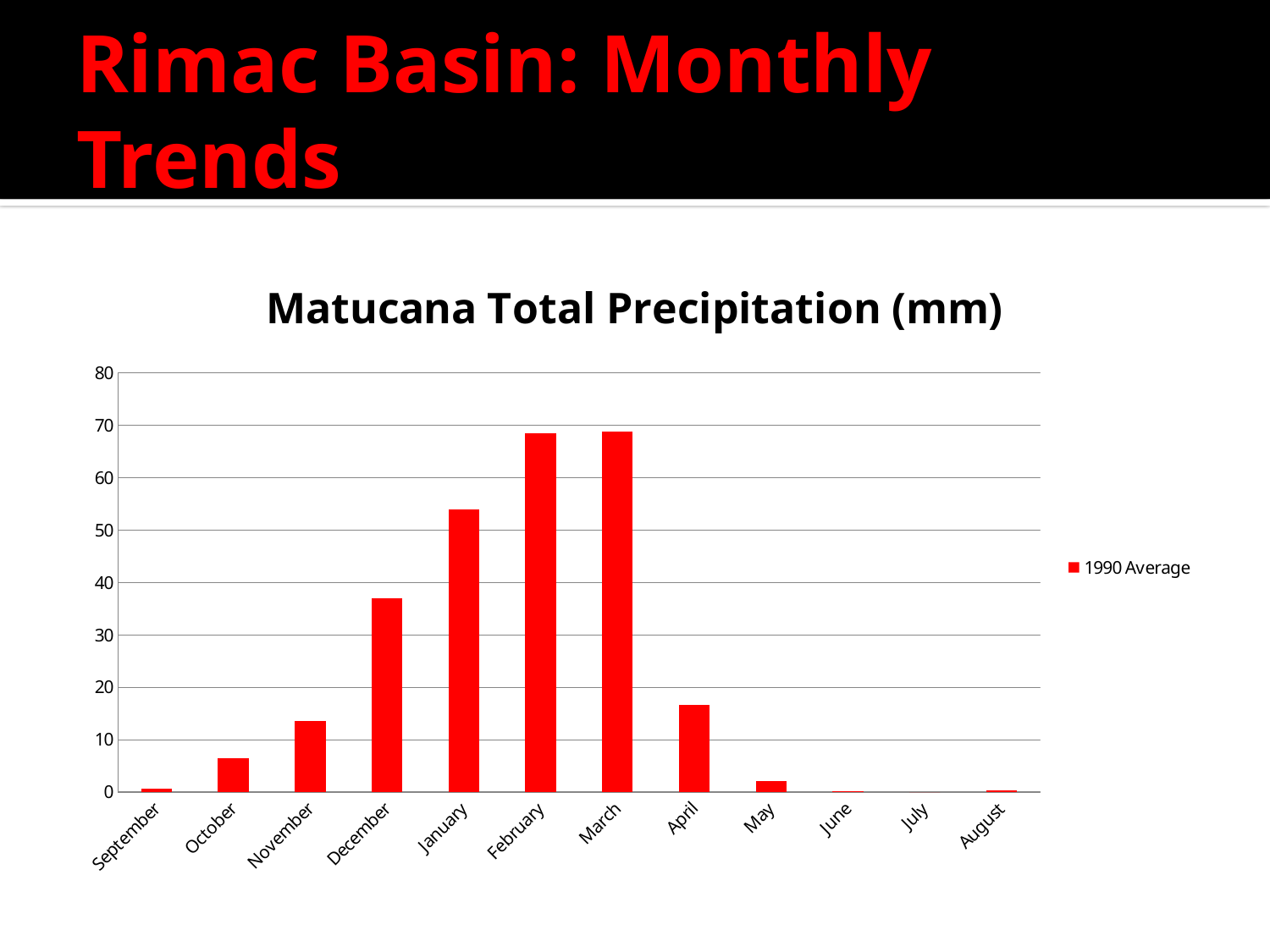
How many months are shown on the x axis? 12 How many series does the legend list? 1 Is the value for October greater or less than 10? less Is the value for April greater or less than 20? less Is the value for January greater or less than 50? greater Which month has the larger value, December or January? January What is the title of the chart? Matucana Total Precipitation (mm) What kind of chart is shown on the slide? bar chart Which month has the larger value, April or May? April What series does the legend list? 1990 Average Do the values rise or fall from September through March? rise